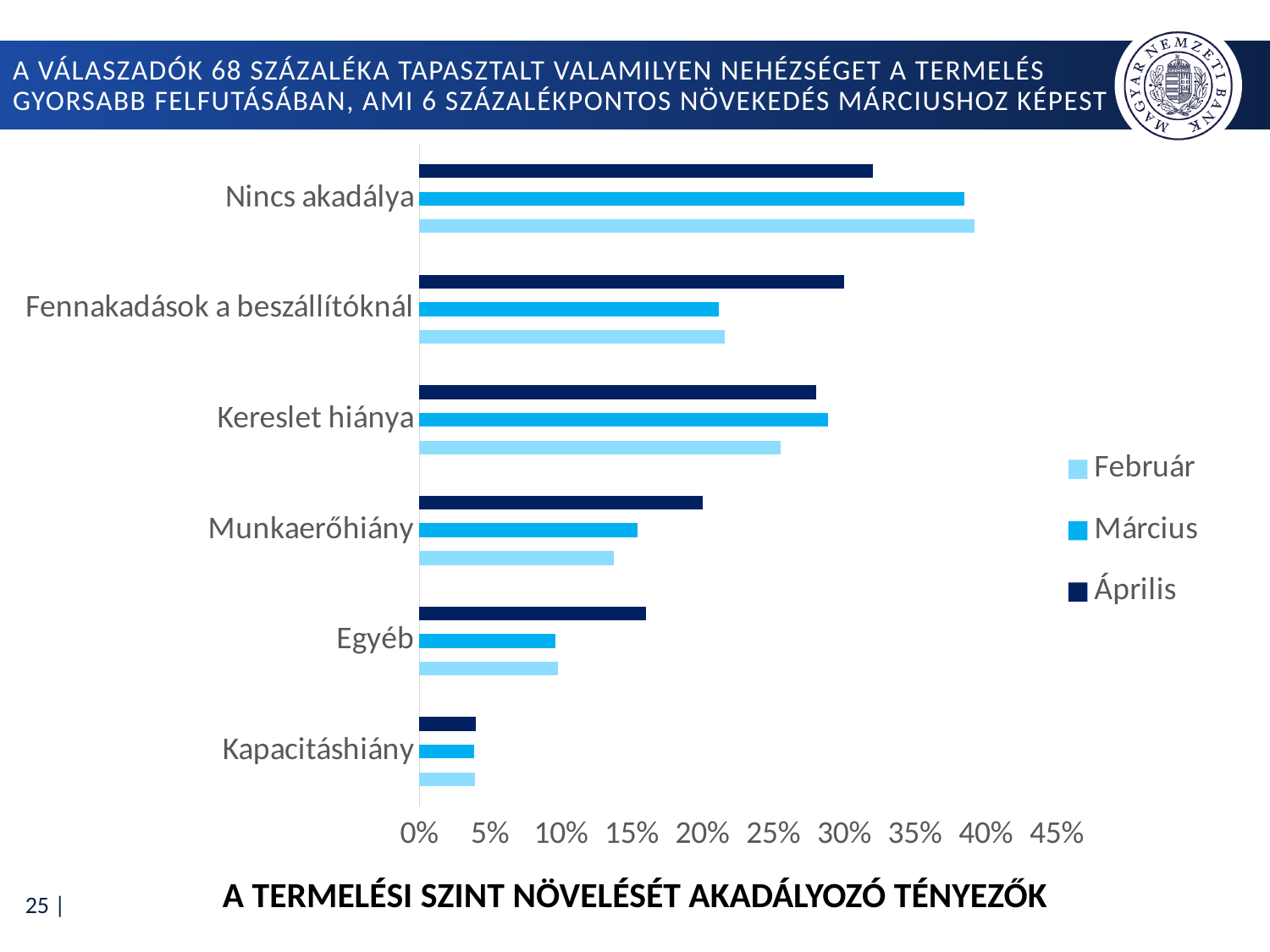
Is the Április value for Fennakadások a beszállítóknál greater or less than 25%? greater What is the title shown below the chart? A TERMELÉSI SZINT NÖVELÉSÉT AKADÁLYOZÓ TÉNYEZŐK How many series does the legend list? 3 Which category has the lowest value for the Április series? Kapacitáshiány Which category has the highest value for the Április series? Nincs akadálya Is the Február value for Munkaerőhiány greater or less than 15%? less How many categories are shown on the chart? 6 What kind of chart is shown on the slide? bar chart Is the Április value for Kapacitáshiány greater or less than 5%? less For Fennakadások a beszállítóknál, which is larger: the Április value or the Február value? Április For Egyéb, which is larger: the Április value or the Március value? Április